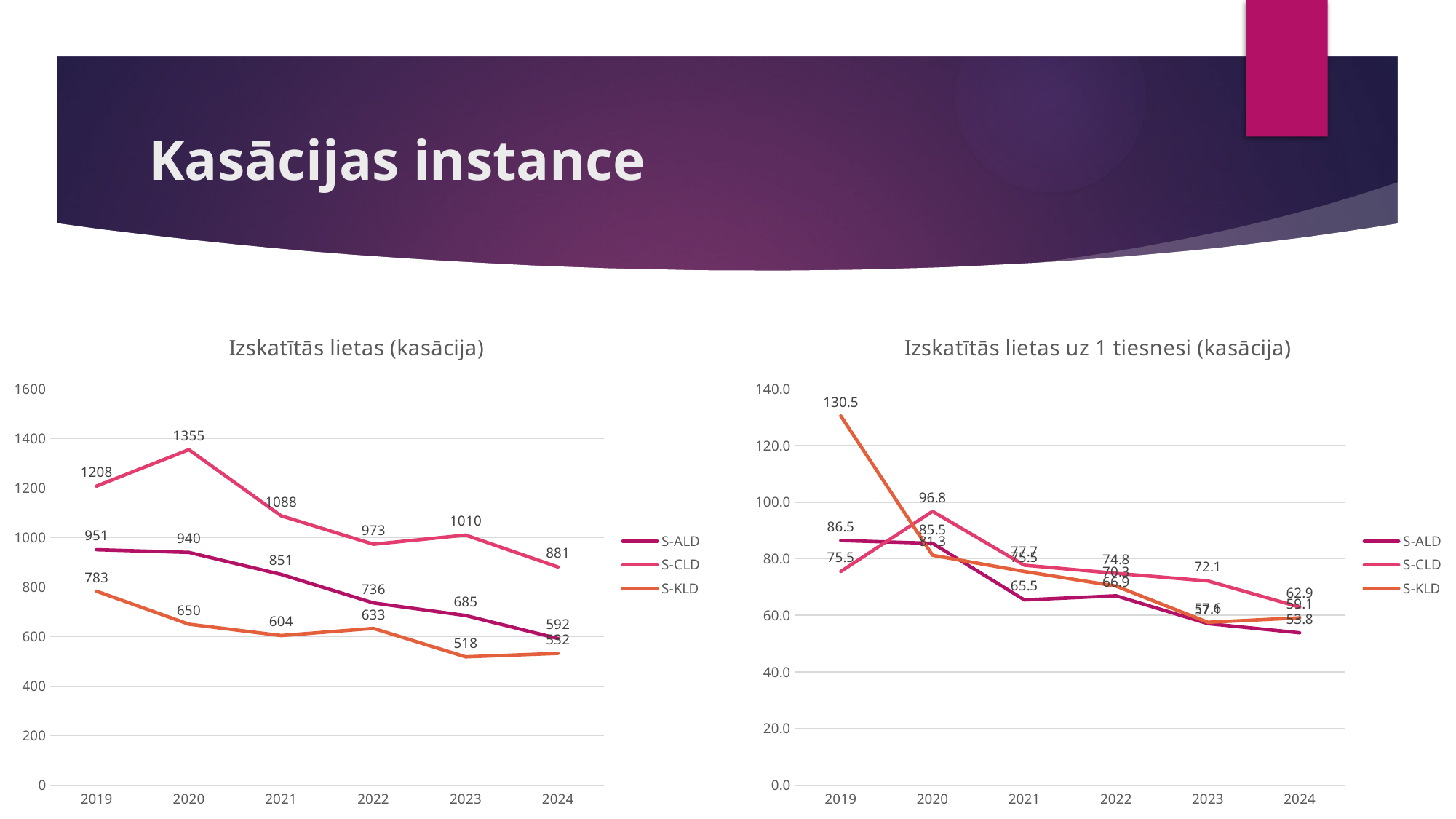
In the chart titled "Izskatītās lietas uz 1 tiesnesi (kasācija)", what is the difference between the S-ALD values for 2019 and 2024? 32.7 In the chart titled "Izskatītās lietas (kasācija)", what is the value for S-KLD in 2023? 518 In the chart titled "Izskatītās lietas (kasācija)", in which year does S-CLD reach its highest value? 2020 How many series does the legend of the chart titled "Izskatītās lietas uz 1 tiesnesi (kasācija)" list? 3 In the chart titled "Izskatītās lietas (kasācija)", how many years are shown on the x axis? 6 In the chart titled "Izskatītās lietas (kasācija)", what is the value for S-CLD in 2020? 1355 In the chart titled "Izskatītās lietas (kasācija)", does the S-ALD series rise or fall from 2019 to 2024? fall What kind of chart is the chart titled "Izskatītās lietas (kasācija)"? line chart In the chart titled "Izskatītās lietas (kasācija)", what is the difference between the S-CLD values for 2019 and 2024? 327 In the chart titled "Izskatītās lietas uz 1 tiesnesi (kasācija)", what is the value for S-KLD in 2019? 130.5 In the chart titled "Izskatītās lietas uz 1 tiesnesi (kasācija)", which series has the highest value in 2019? S-KLD In the chart titled "Izskatītās lietas (kasācija)", which series has the larger value in 2024, S-ALD or S-KLD? S-ALD